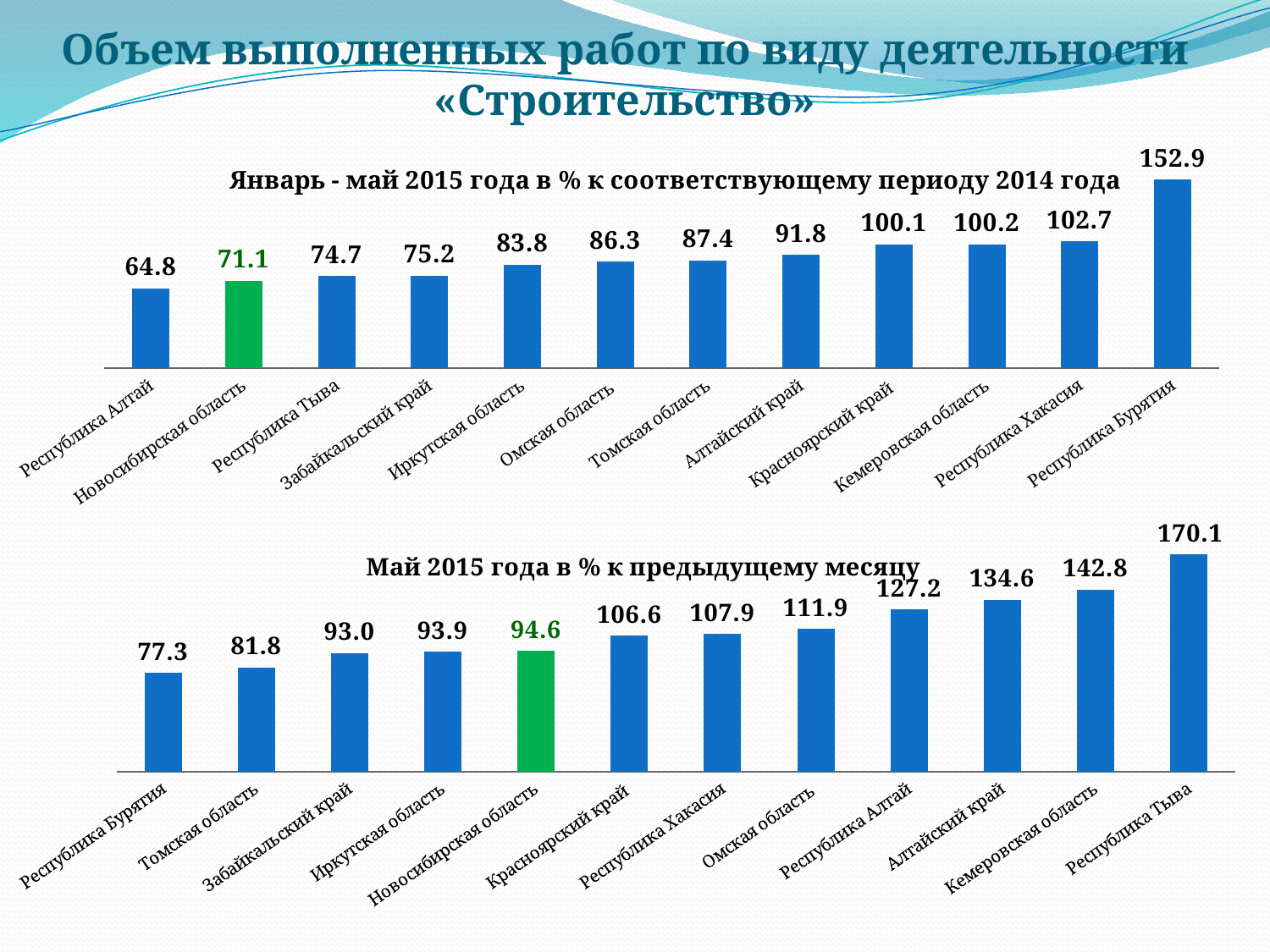
In the chart titled «Январь - май 2015 года в % к соответствующему периоду 2014 года», what is the difference between the values for Республика Бурятия and Республика Алтай? 88.1 In the chart titled «Май 2015 года в % к предыдущему месяцу», what is the value for Новосибирская область? 94.6 In the chart titled «Январь - май 2015 года в % к соответствующему периоду 2014 года», which region has the lowest value? Республика Алтай What type of chart is the chart titled «Май 2015 года в % к предыдущему месяцу»? bar chart In the chart titled «Январь - май 2015 года в % к соответствующему периоду 2014 года», how many regions are shown? 12 In the chart titled «Май 2015 года в % к предыдущему месяцу», which is larger, the value for Омская область or the value for Красноярский край? Омская область In the chart titled «Май 2015 года в % к предыдущему месяцу», what is the difference between the values for Кемеровская область and Алтайский край? 8.2 In the chart titled «Январь - май 2015 года в % к соответствующему периоду 2014 года», what is the value for Новосибирская область? 71.1 In the chart titled «Январь - май 2015 года в % к соответствующему периоду 2014 года», which region has the highest value? Республика Бурятия In the chart titled «Январь - май 2015 года в % к соответствующему периоду 2014 года», do the values rise or fall from left to right? rise In the chart titled «Май 2015 года в % к предыдущему месяцу», which region has the lowest value? Республика Бурятия In the chart titled «Май 2015 года в % к предыдущему месяцу», what is the value for Республика Тыва? 170.1